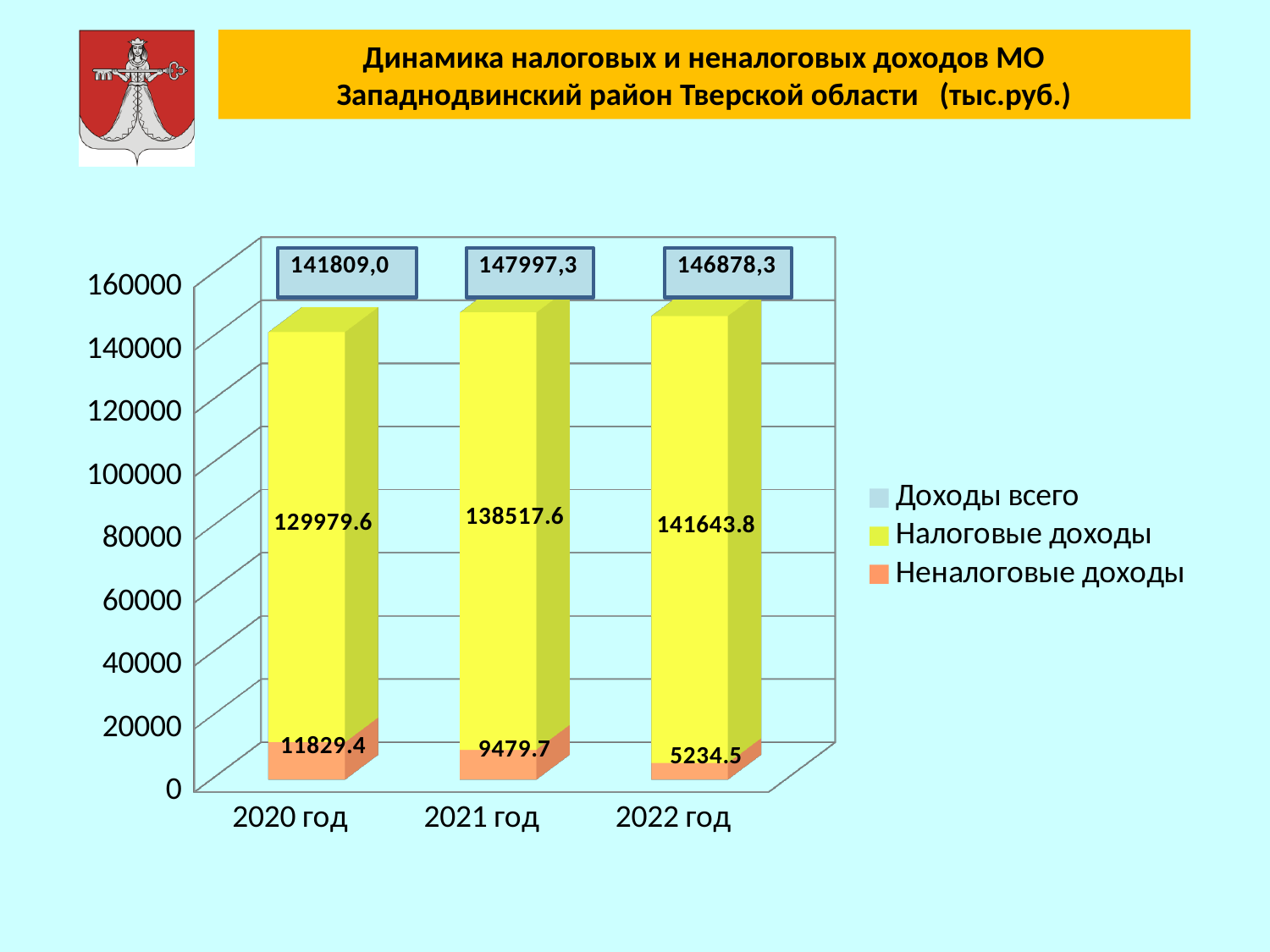
How many series does the legend list? 3 What kind of chart is shown on the slide? Stacked bar chart Which year has the lowest value of Неналоговые доходы? 2022 год Do the values of Неналоговые доходы rise or fall from 2020 год to 2022 год? Fall Is the value of Налоговые доходы for 2021 год larger than for 2020 год? Yes What is the value of Неналоговые доходы for 2022 год? 5234.5 What is the value of Налоговые доходы for 2021 год? 138517.6 How many years are shown on the x axis? 3 What is the difference between Неналоговые доходы in 2020 год and 2021 год? 2349.7 Which year has the highest value of Налоговые доходы? 2022 год What is the value of Налоговые доходы for 2020 год? 129979.6 What total (Доходы всего) is shown in the box above the 2021 год bar? 147997,3